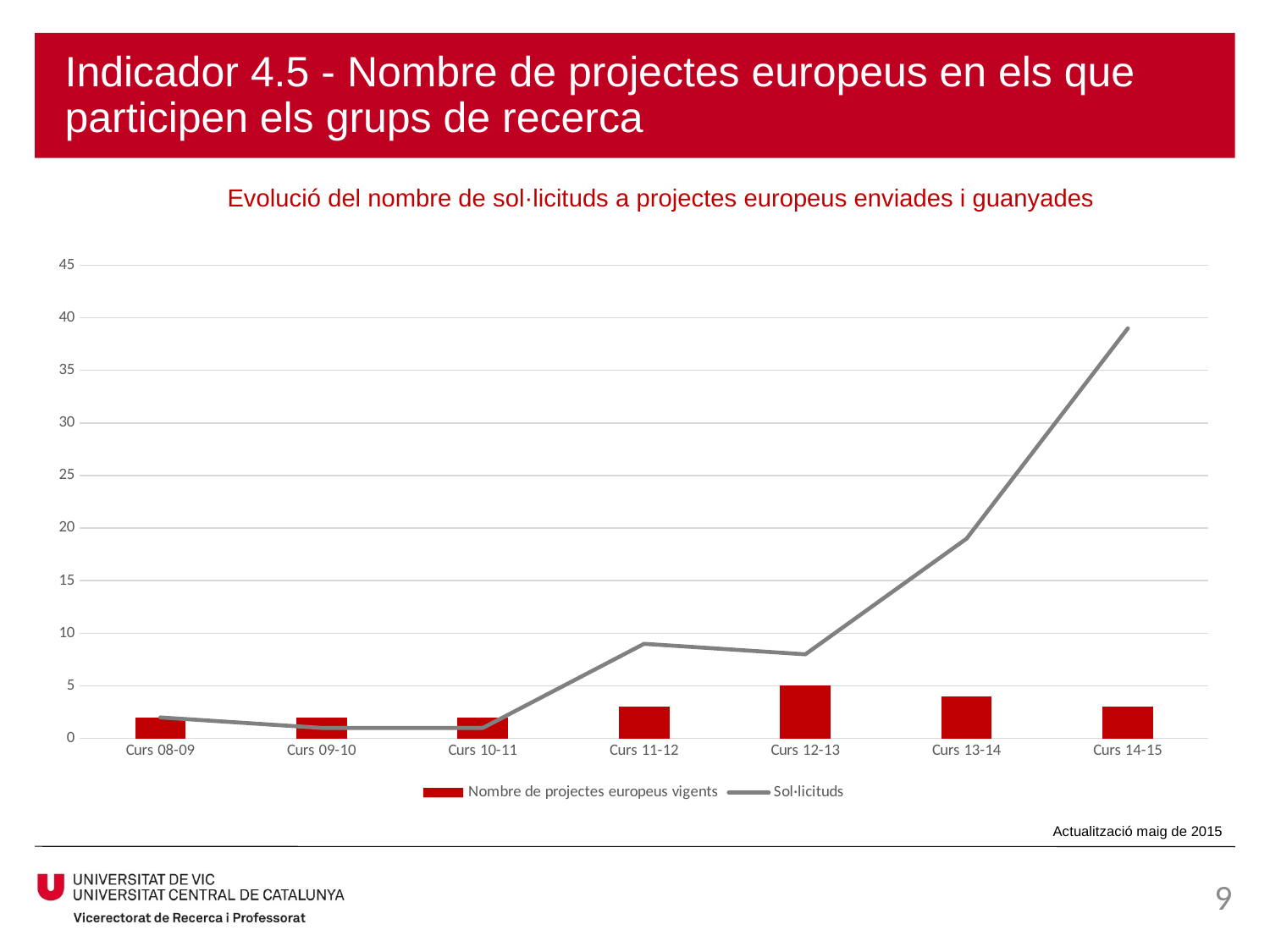
How many academic years (Curs) are shown on the x axis? 7 Which is larger, the Sol·licituds value for Curs 14-15 or for Curs 13-14? Curs 14-15 How many series does the chart legend list? 2 Is the Sol·licituds value for Curs 14-15 greater or less than 35? greater Which academic year has the tallest bar for Nombre de projectes europeus vigents? Curs 12-13 What kind of chart is shown on the slide? A combined bar and line chart What is the value of Nombre de projectes europeus vigents for Curs 12-13? 5 Does the Sol·licituds line rise or fall from Curs 10-11 to Curs 14-15? It rises Is the Sol·licituds value for Curs 13-14 greater or less than 15? greater In which academic year is the Sol·licituds line at its highest? Curs 14-15 What is the title of the chart? Evolució del nombre de sol·licituds a projectes europeus enviades i guanyades Is the Sol·licituds value for Curs 11-12 greater or less than 5? greater